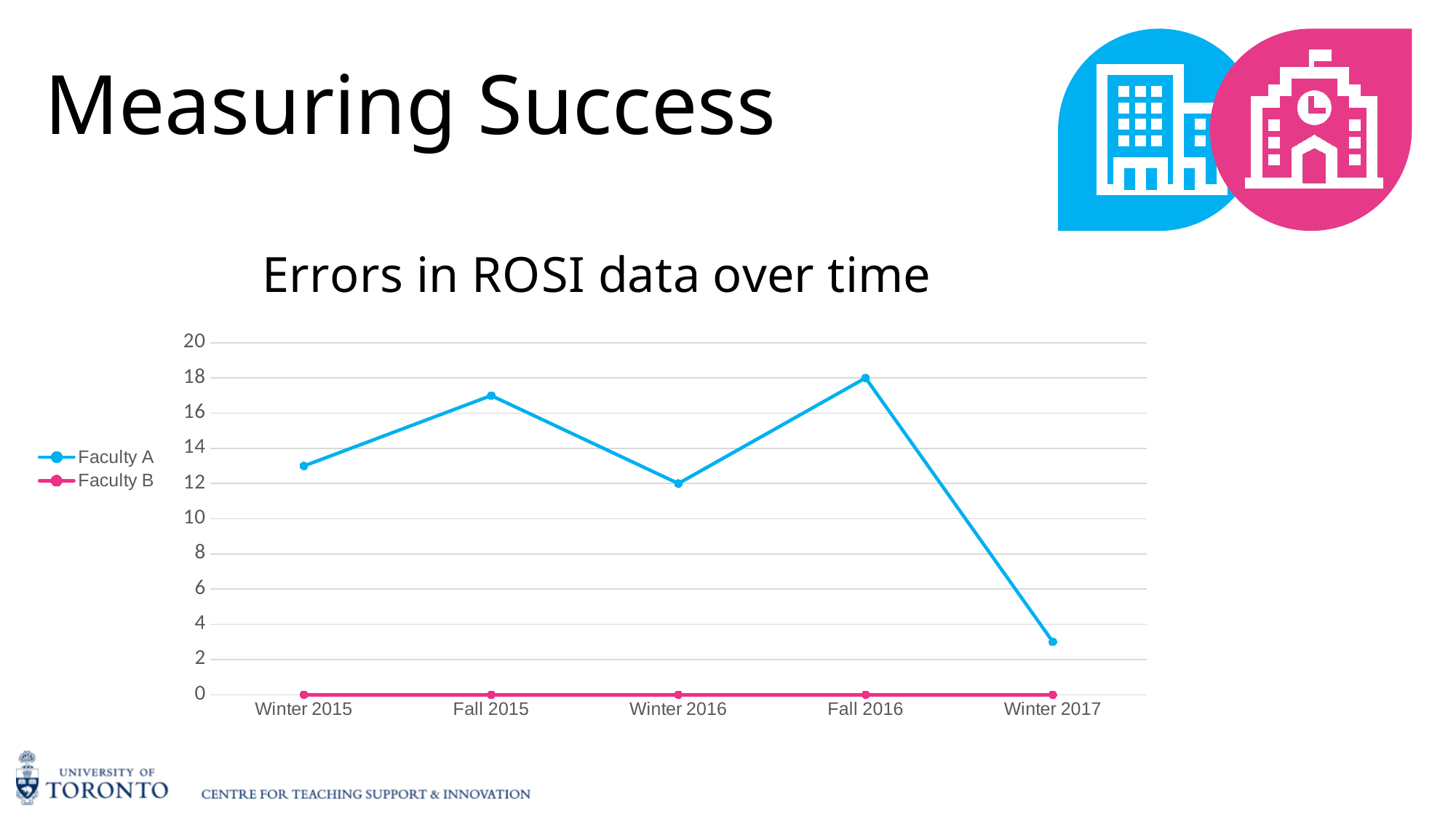
How many time periods are shown on the x axis? 5 In which period is the value for Faculty A lowest? Winter 2017 What is the title of the chart? Errors in ROSI data over time Is the value for Faculty A in Winter 2017 greater or less than 4? less What kind of chart is shown on the slide? line chart Which series has the larger value in Fall 2016, Faculty A or Faculty B? Faculty A How many series does the legend list? 2 Is the value for Faculty A in Fall 2015 greater or less than 16? greater In which period is the value for Faculty A highest? Fall 2016 What is the value for Faculty A in Winter 2016? 12 What is the value for Faculty B in Winter 2017? 0 What is the value for Faculty A in Fall 2016? 18